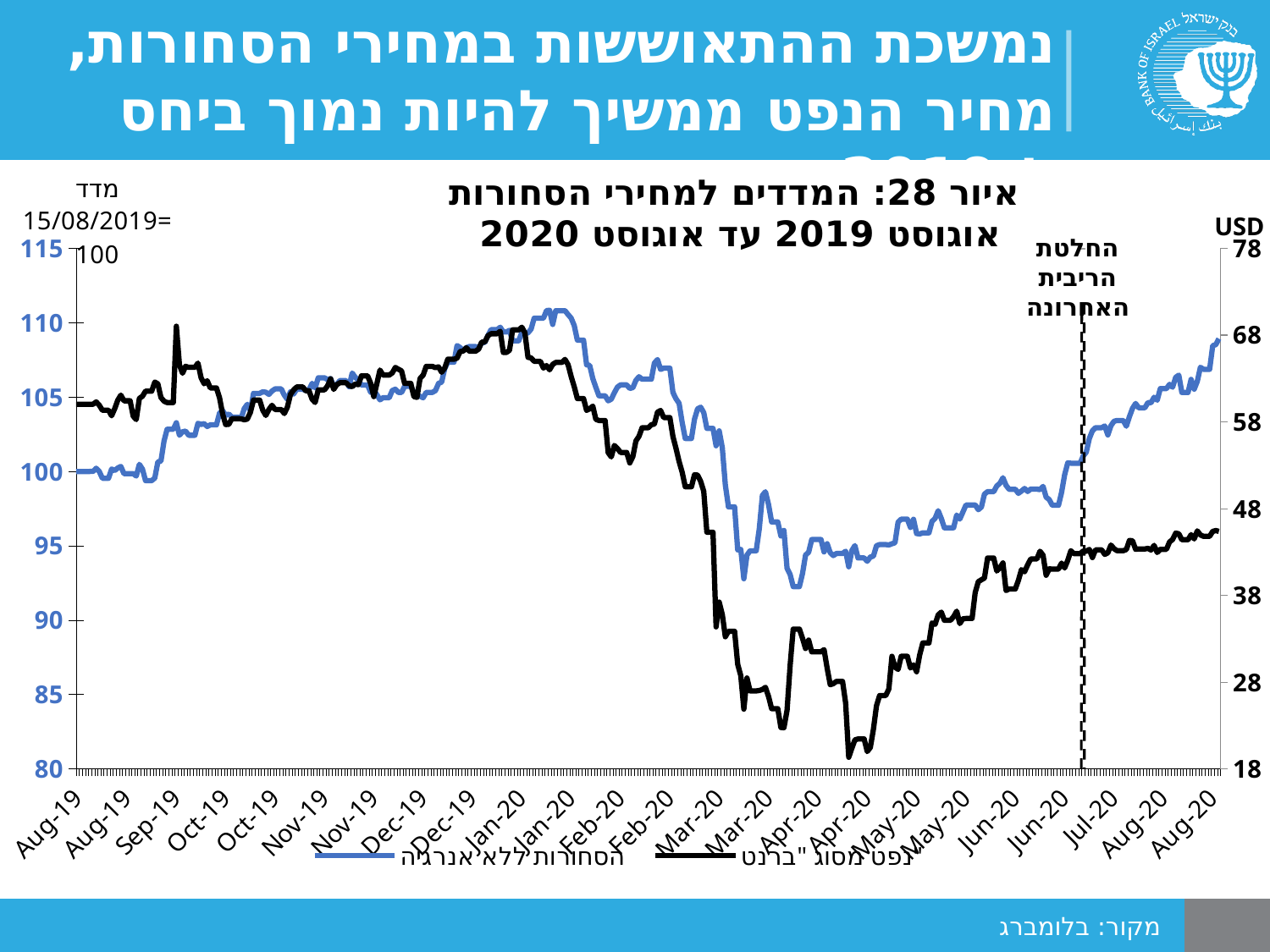
What source is cited at the bottom of the slide for the chart? בלומברג What unit is shown at the top of the right-hand axis? USD Is the lowest point of the blue line (commodities excluding energy), reached around Apr-20, greater or less than 95 on the left axis? less Is the value of the black line (Brent oil) at the start of the series in Aug-19 greater or less than 48 USD on the right axis? greater Is the value of the black line (Brent oil) at the end of the series in Aug-20 greater or less than 38 USD on the right axis? greater Does the blue line (commodities excluding energy) rise or fall between Aug-19 and Jan-20? rise How many series does the legend list? 2 What kind of chart is shown on the slide? line chart Does the black line (Brent oil) rise or fall between Jan-20 and Apr-20? fall Does the blue line (commodities excluding energy) rise or fall between Apr-20 and Aug-20? rise